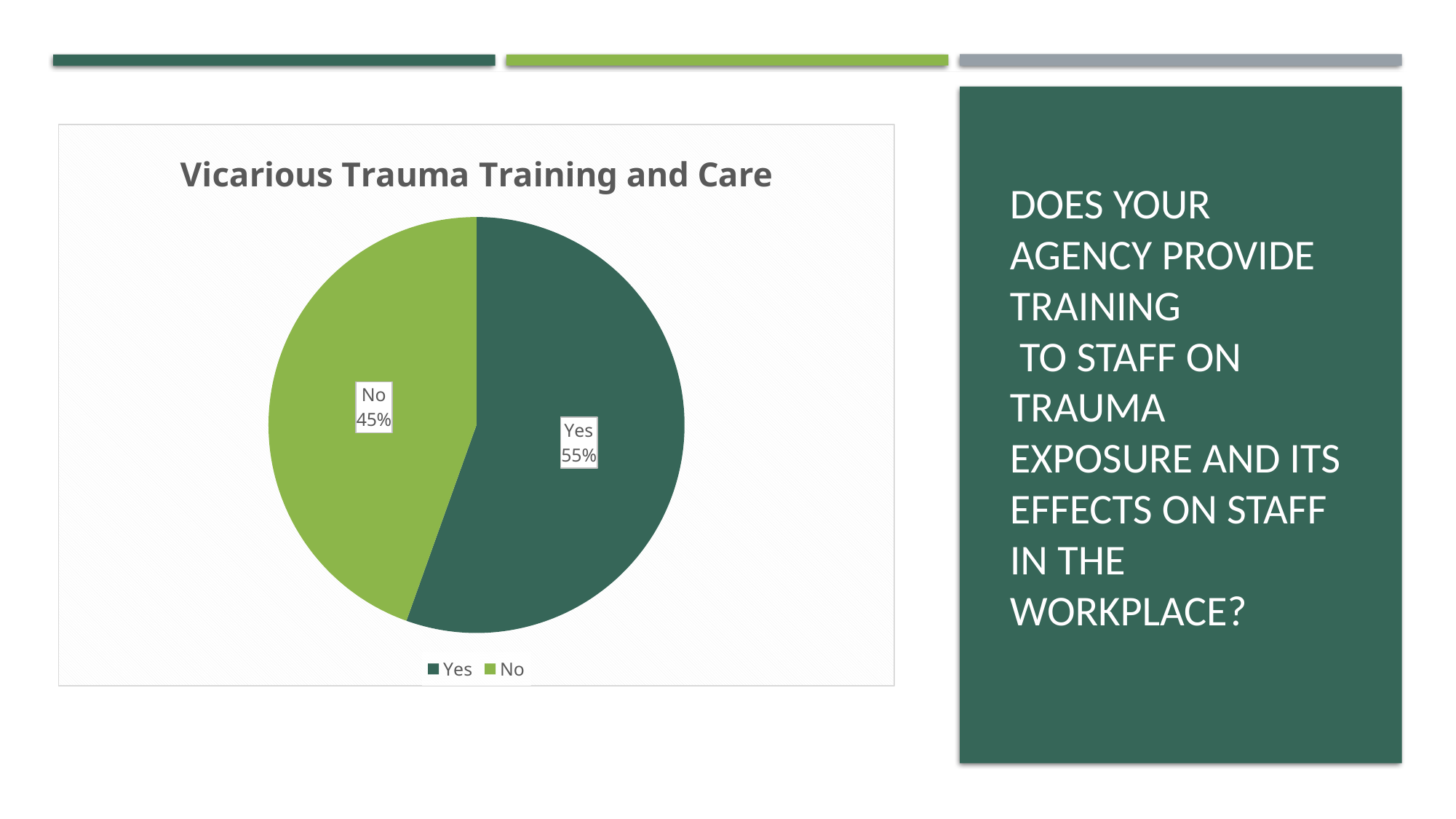
What is the difference in percentage points between the Yes and No slices? 10% Which slice is the smallest in the pie chart? No Which is larger, the Yes slice or the No slice? Yes How many entries does the legend list? 2 How many slices does the pie chart have? 2 What kind of chart is shown on the slide? pie chart What share of the pie does the Yes slice represent? 55% What share of the pie does the No slice represent? 45% What colour is the No slice in the pie chart? light green Which slice is the largest in the pie chart? Yes What is the title of the chart? Vicarious Trauma Training and Care Is the value for Yes greater or less than 50%? greater